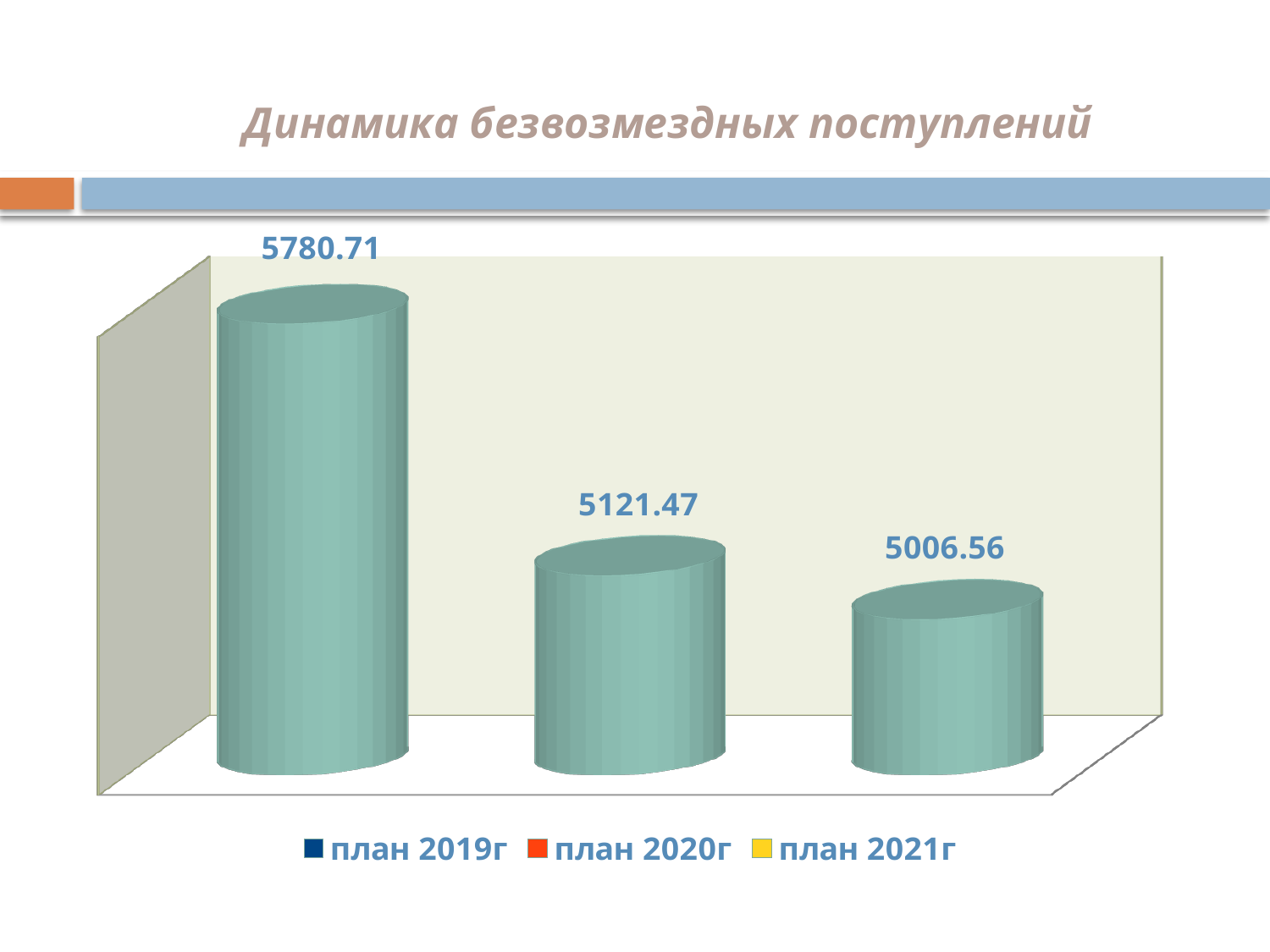
Which is larger, the value for план 2019г or the value for план 2021г? план 2019г What is the difference between the values for план 2020г and план 2021г? 114.91 What is the difference between the values for план 2019г and план 2020г? 659.24 How many entries does the legend list? 3 Which legend entry has the highest value on the chart? план 2019г What is the value shown for план 2021г? 5006.56 Do the values rise or fall from left to right across the chart? fall Which legend entry has the lowest value on the chart? план 2021г What kind of chart is shown on the slide? bar chart How many bars are plotted on the chart? 3 What is the value shown for план 2020г? 5121.47 What is the value shown for план 2019г? 5780.71